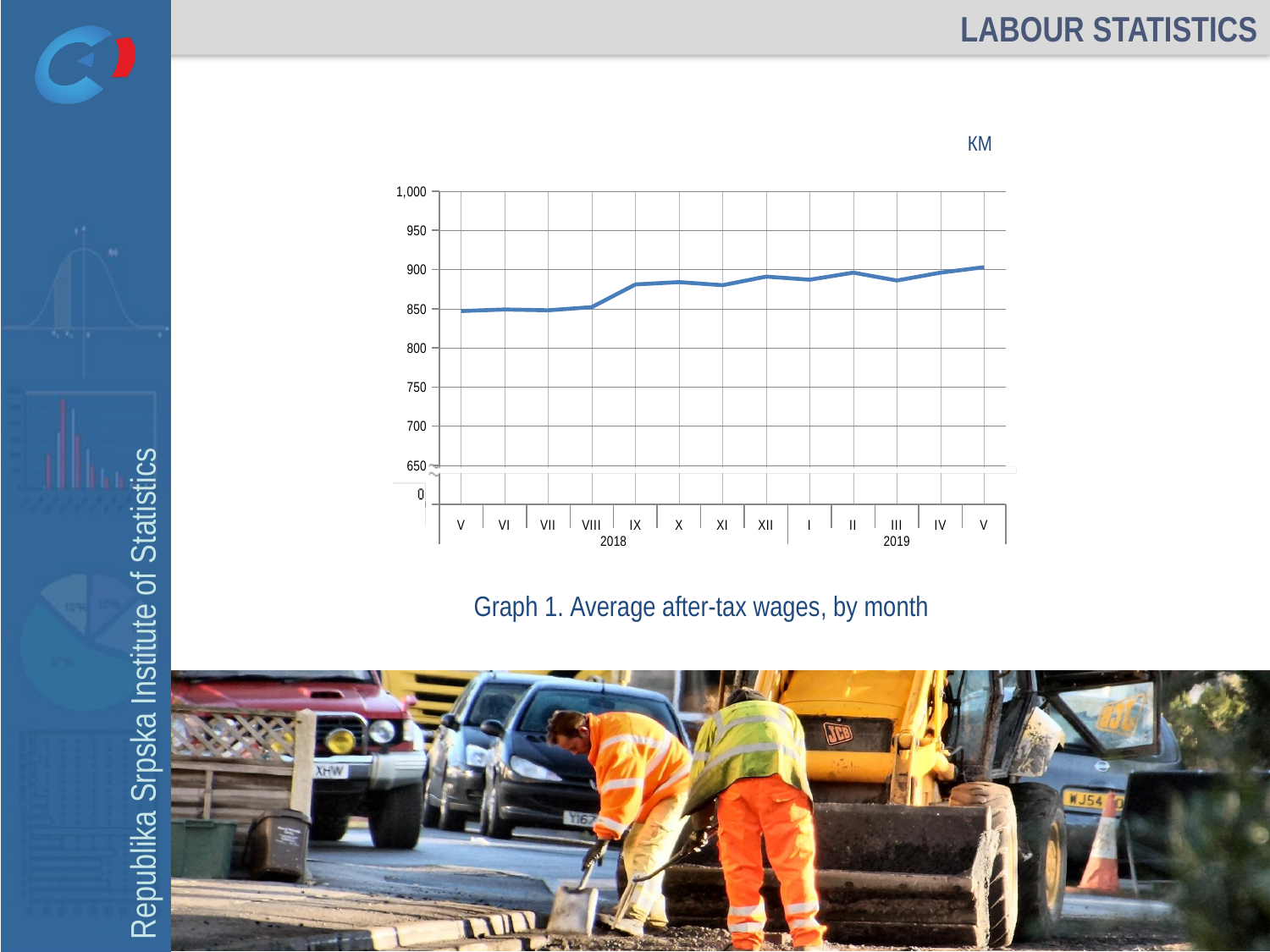
Is the value for V 2018 greater or less than 900? less Is the value for IX 2018 greater or less than 850? greater Is the value for VIII 2018 greater or less than 900? less How many monthly data points are plotted in Graph 1? 13 Which is larger, the value for VII 2018 or the value for IV 2019? IV 2019 Overall, do the average after-tax wages rise or fall from V 2018 to V 2019? rise What unit is shown above the chart for the plotted values? KM What is the title of the chart on the slide? Graph 1. Average after-tax wages, by month What kind of chart is Graph 1? line chart Which is larger, the value for IX 2018 or the value for V 2018? IX 2018 Which is larger, the value for VIII 2018 or the value for XII 2018? XII 2018